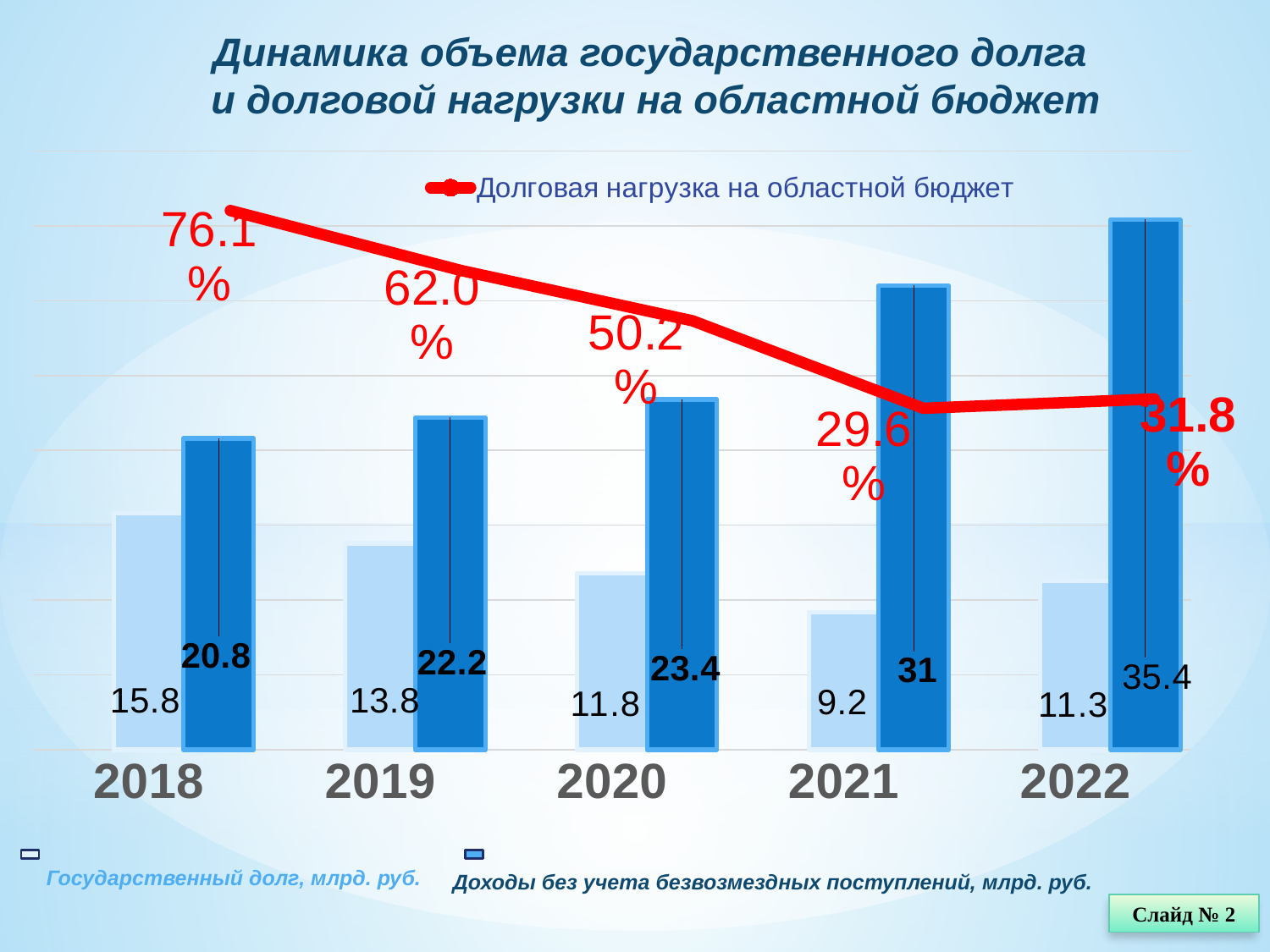
Which is larger in 2019: Государственный долг or Доходы без учета безвозмездных поступлений? Доходы без учета безвозмездных поступлений In which year is Государственный долг lowest? 2021 What kind of chart is used for Государственный долг and Доходы без учета безвозмездных поступлений? bar chart How many years are shown on the x axis? 5 Does Доходы без учета безвозмездных поступлений rise or fall from 2018 to 2022? rise How many data series does the chart show? 3 In which year is Долговая нагрузка на областной бюджет highest? 2018 What is the Долговая нагрузка на областной бюджет value for 2020? 50.2% What is the difference between Доходы без учета безвозмездных поступлений in 2021 and in 2020? 7.6 What is the value of Доходы без учета безвозмездных поступлений for 2022? 35.4 What is the value of Государственный долг for 2018? 15.8 What colour is the Долговая нагрузка на областной бюджет line? red